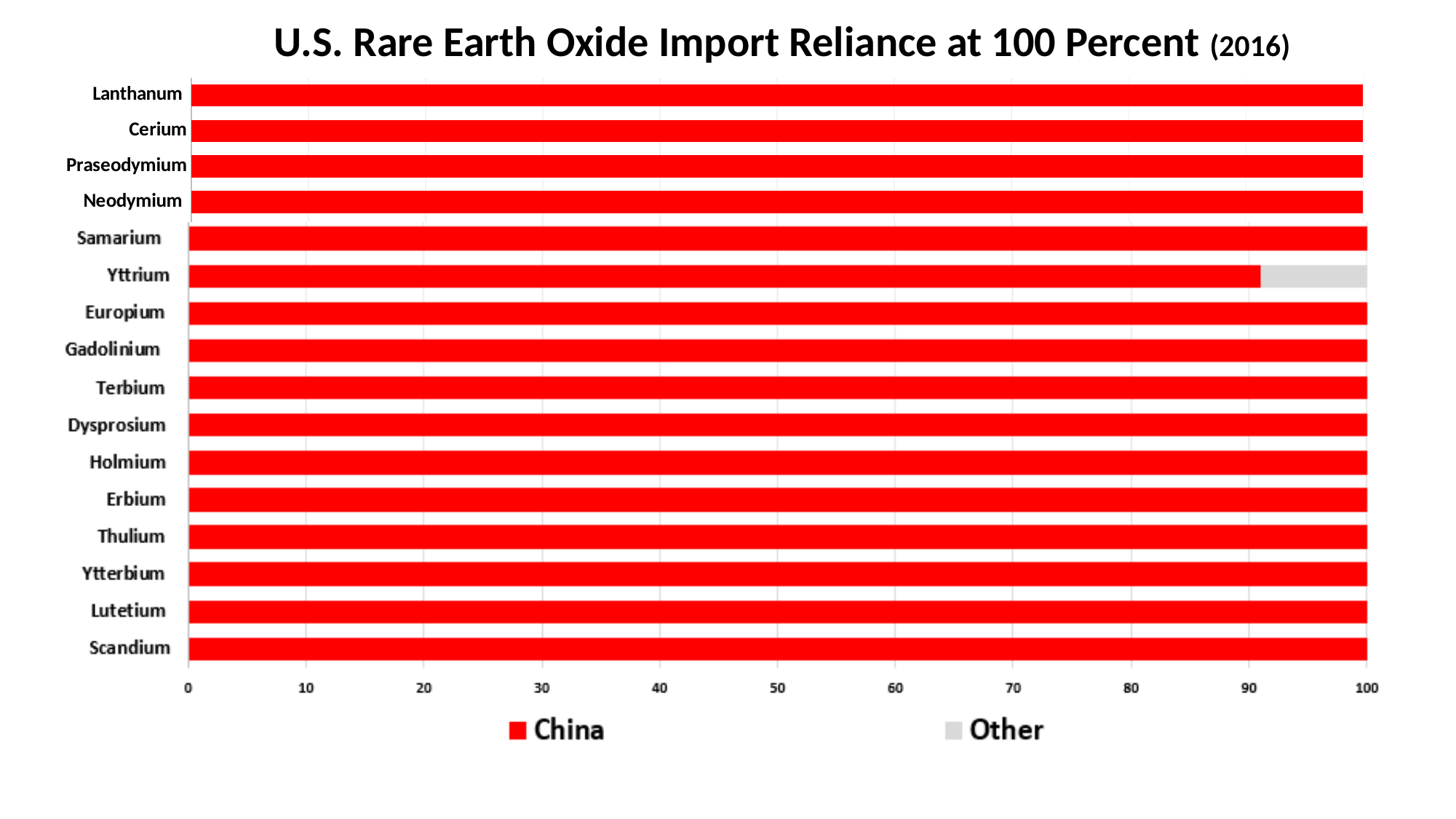
What kind of chart is shown on the slide? Bar chart How many series does the legend list? 2 Which category is the only one with a visible Other segment? Yttrium How many rare earth oxide categories are plotted on the chart? 16 Which category has the lowest value for China? Yttrium Which series is shown in red in the legend? China What value does the bar for Scandium reach on the x axis? 100 Is the China value for Yttrium greater or less than 80? greater What is the highest tick value shown on the x axis? 100 What is the title of the chart? U.S. Rare Earth Oxide Import Reliance at 100 Percent (2016) Is the Other value for Yttrium greater or less than 20? less Which has a larger China value, Samarium or Yttrium? Samarium